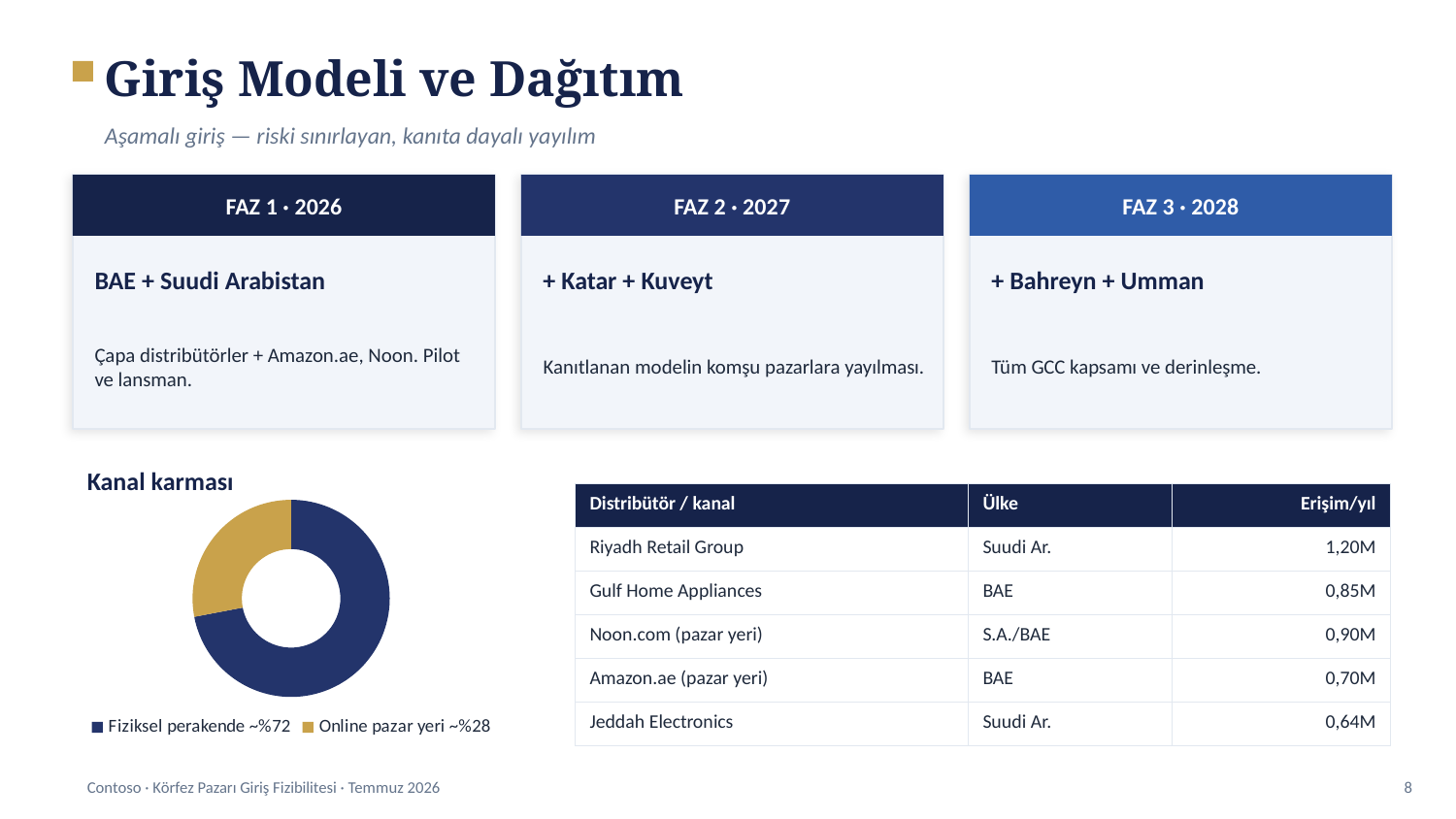
What colour is the Online pazar yeri slice in the "Kanal karması" chart? gold How many entries does the legend of the "Kanal karması" chart list? 2 What is the title of the pie chart on the slide? Kanal karması Which category takes the largest share of the "Kanal karması" chart? Fiziksel perakende How many slices does the "Kanal karması" chart have? 2 In the "Kanal karması" chart, which is larger: Fiziksel perakende or Online pazar yeri? Fiziksel perakende What kind of chart is shown under the heading "Kanal karması"? pie chart (donut) In the "Kanal karması" chart, does Fiziksel perakende account for more or less than half of the chart? more Which category takes the smallest share of the "Kanal karması" chart? Online pazar yeri